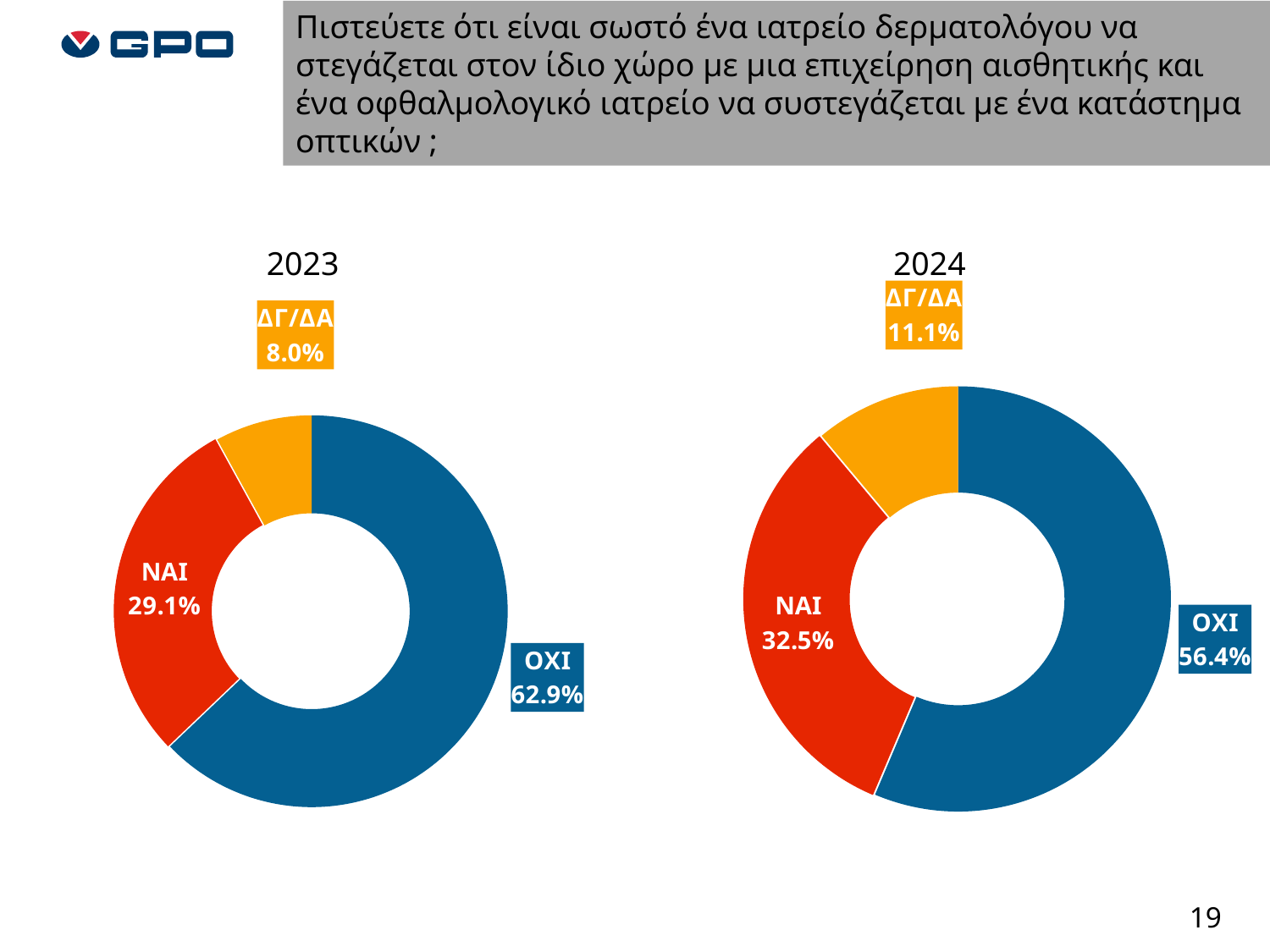
In the 2024 chart, which category has the largest share? ΟΧΙ In the 2024 chart, what is the value for ΔΓ/ΔΑ? 11.1% In the 2023 chart, which category has the smallest share? ΔΓ/ΔΑ How many categories does the 2024 chart show? 3 What kind of chart is the 2023 chart? Doughnut (pie) chart In the 2023 chart, what is the difference between ΟΧΙ and ΝΑΙ? 33.8% In the 2023 chart, what is the value for ΔΓ/ΔΑ? 8.0% In the 2024 chart, what is the value for ΝΑΙ? 32.5% In the 2023 chart, what is the value for ΟΧΙ? 62.9% Which is larger: ΝΑΙ in the 2023 chart or ΝΑΙ in the 2024 chart? ΝΑΙ in 2024 What is the difference between the ΟΧΙ value in the 2023 chart and the ΟΧΙ value in the 2024 chart? 6.5% What colour is the ΟΧΙ segment in both charts? Blue